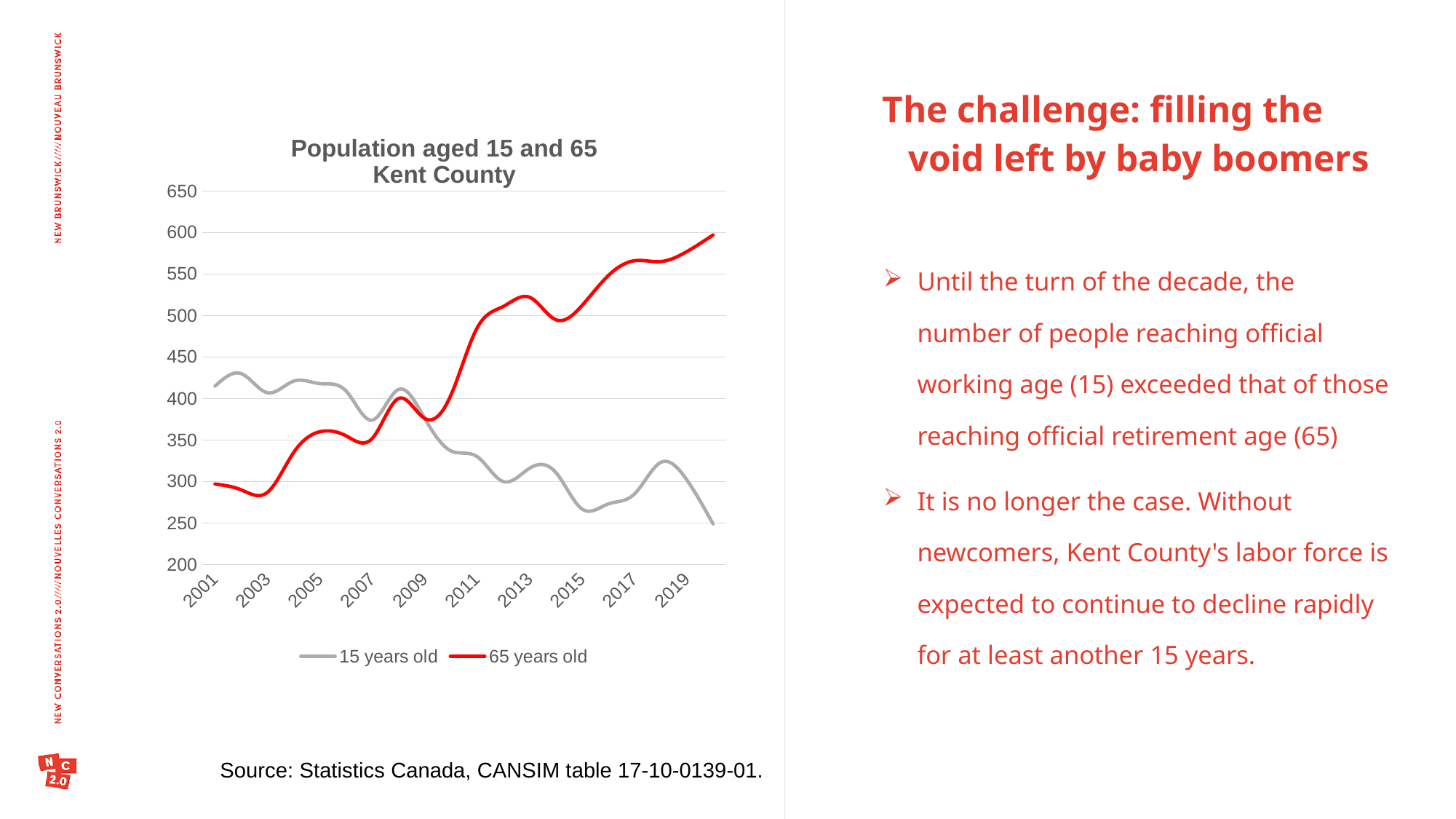
Does the 15 years old line generally rise or fall from 2001 to the end of the series? fall What kind of chart is shown on the slide? line chart Is the value for 65 years old in 2019 greater or less than 550? greater Is the value for 65 years old in 2005 greater or less than 400? less In 2001, which series has the higher value, 15 years old or 65 years old? 15 years old Is the value for 15 years old in 2019 greater or less than 350? less How many series does the chart's legend list? 2 Does the 65 years old line generally rise or fall from 2001 to the end of the series? rise What is the title of the chart? Population aged 15 and 65 Kent County What are the two series named in the chart's legend? 15 years old and 65 years old In 2019, which series has the higher value, 15 years old or 65 years old? 65 years old